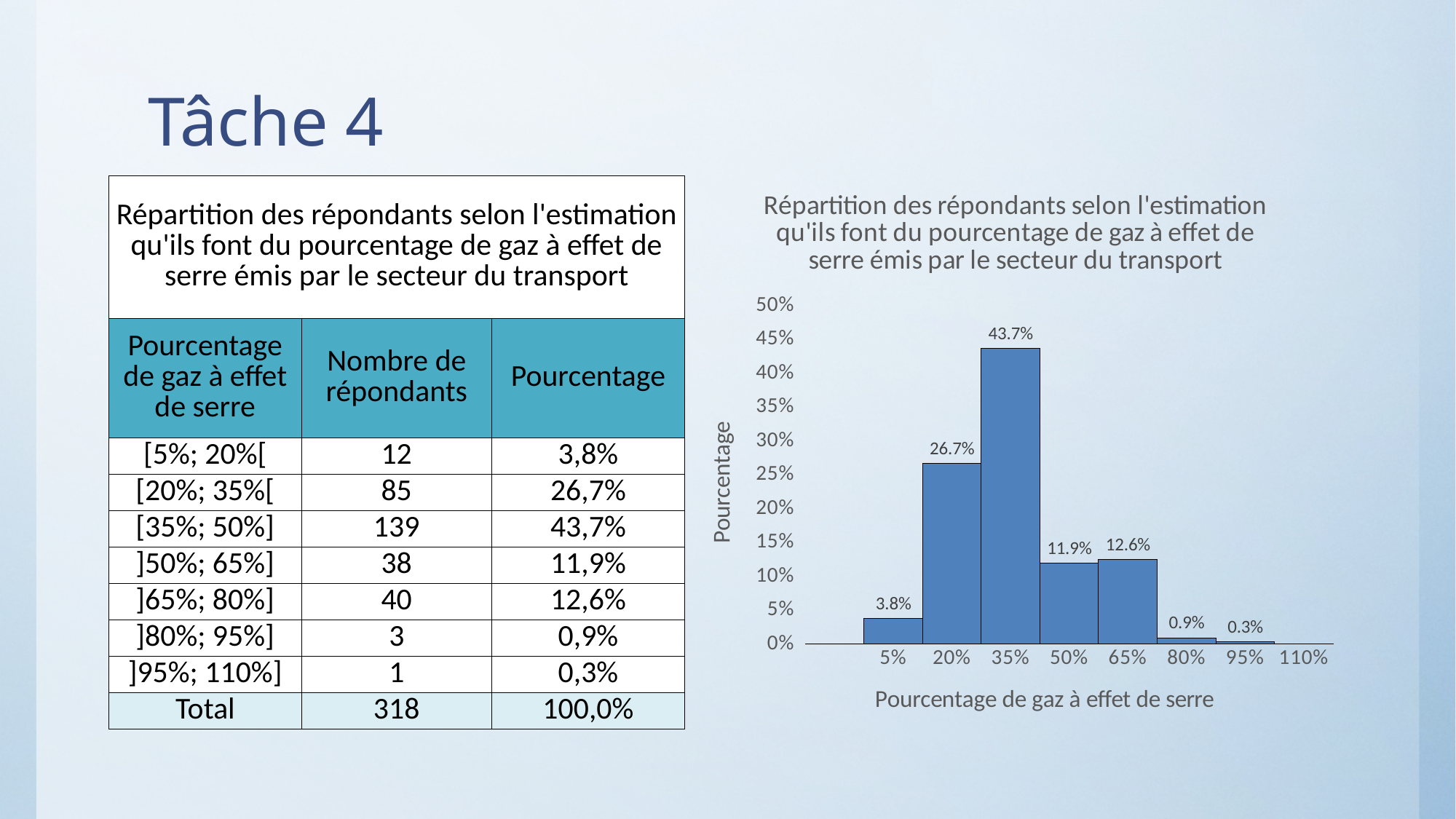
What is the data label on the bar between 20% and 35% on the x axis? 26.7% What type of chart is shown on the slide? bar chart What is the data label on the bar between 35% and 50% on the x axis? 43.7% What is the data label on the bar between 95% and 110% on the x axis? 0.3% Which bar is the shortest in the chart? the bar between 95% and 110% What is the data label on the bar between 65% and 80% on the x axis? 12.6% What is the difference between the data labels of the bar between 35% and 50% and the bar between 20% and 35%? 17.0% Which is larger: the bar between 50% and 65% or the bar between 65% and 80%? the bar between 65% and 80% Which bar is the tallest in the chart? the bar between 35% and 50% How many bars are plotted in the chart? 7 What is the label of the horizontal axis of the chart? Pourcentage de gaz à effet de serre What is the label of the vertical axis of the chart? Pourcentage